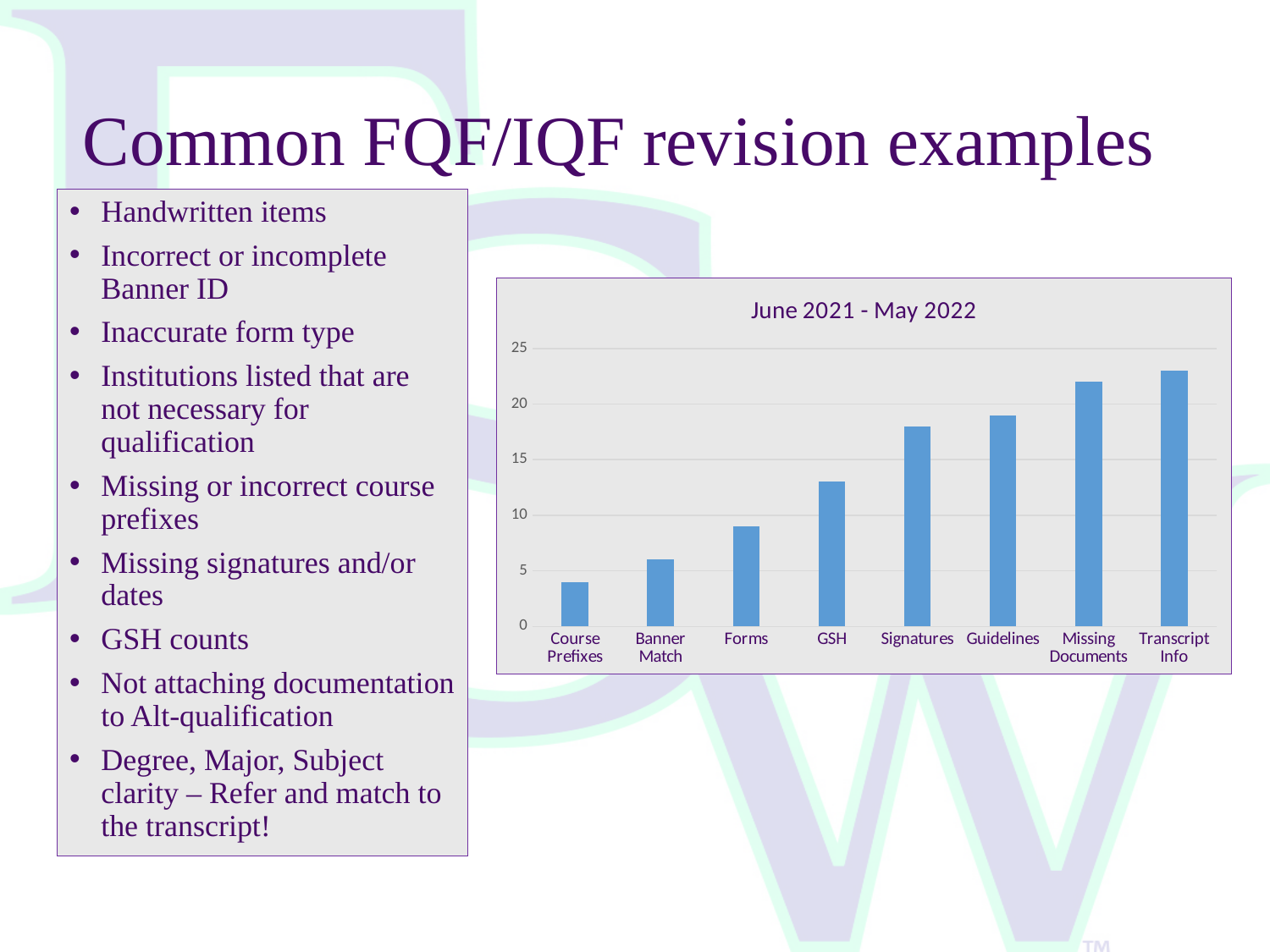
How many categories are shown on the x axis of the chart? 8 Is the value for Missing Documents greater or less than 20? greater Which is larger, the value for GSH or the value for Forms? GSH Which category has the lowest value in the chart? Course Prefixes Is the value for Signatures greater or less than 15? greater Is the value for Banner Match greater or less than 5? greater What is the title of the chart? June 2021 - May 2022 Do the values generally rise or fall from left to right along the x axis? rise What kind of chart is shown on the slide? bar chart